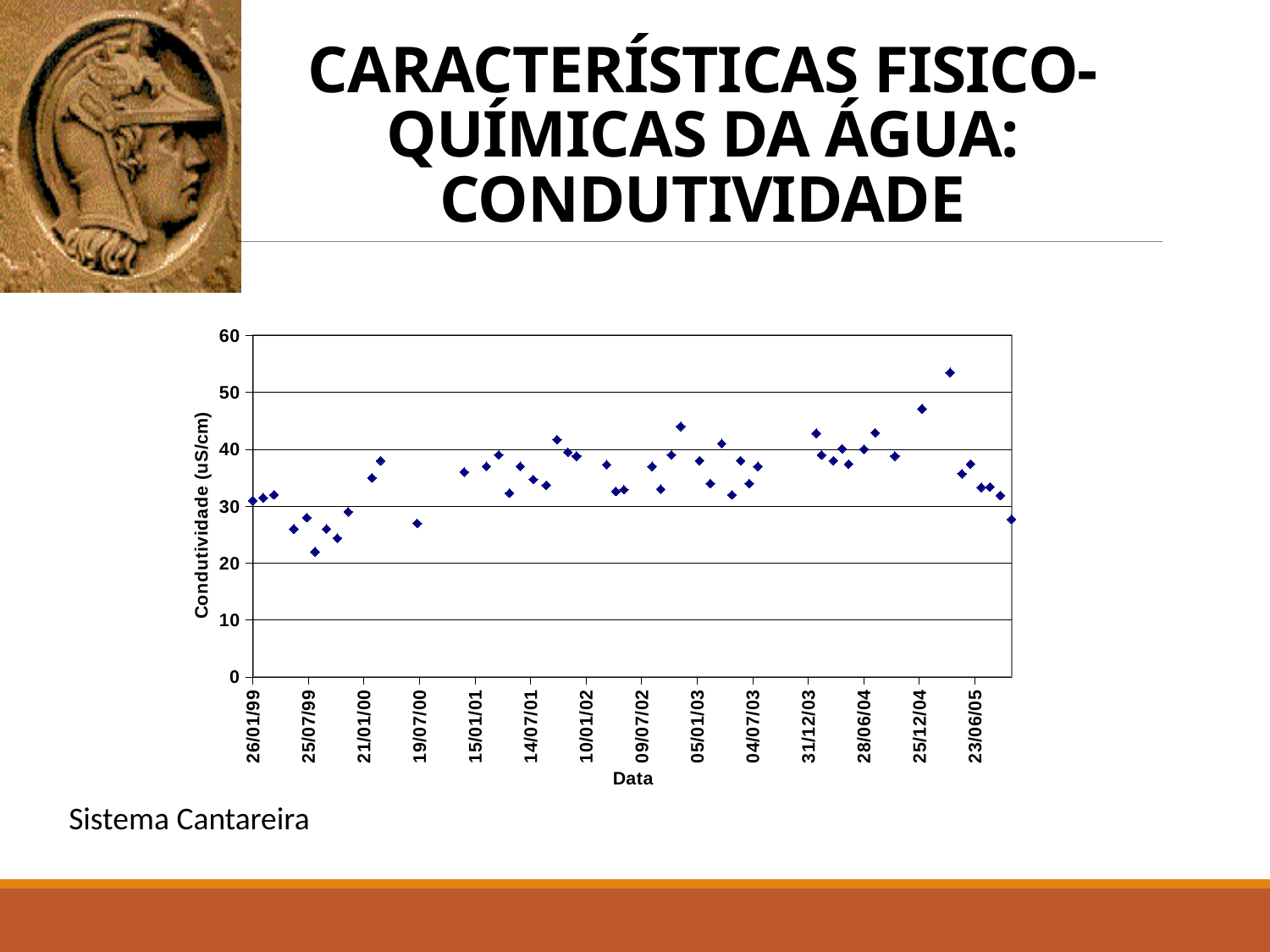
What is the label of the y axis of the chart? Condutividade (uS/cm) How many date labels are shown along the x axis of the chart? 14 Is the last plotted value (after 23/06/05) greater or less than 30? less Is the value plotted near 19/07/00 greater or less than 30? less Do the plotted values generally rise or fall between 25/07/99 and 25/12/04? rise Is the value plotted at 26/01/99 greater or less than 40? less What kind of chart is shown on the slide? scatter chart What is the label of the x axis of the chart? Data What is the maximum value shown on the y axis of the chart? 60